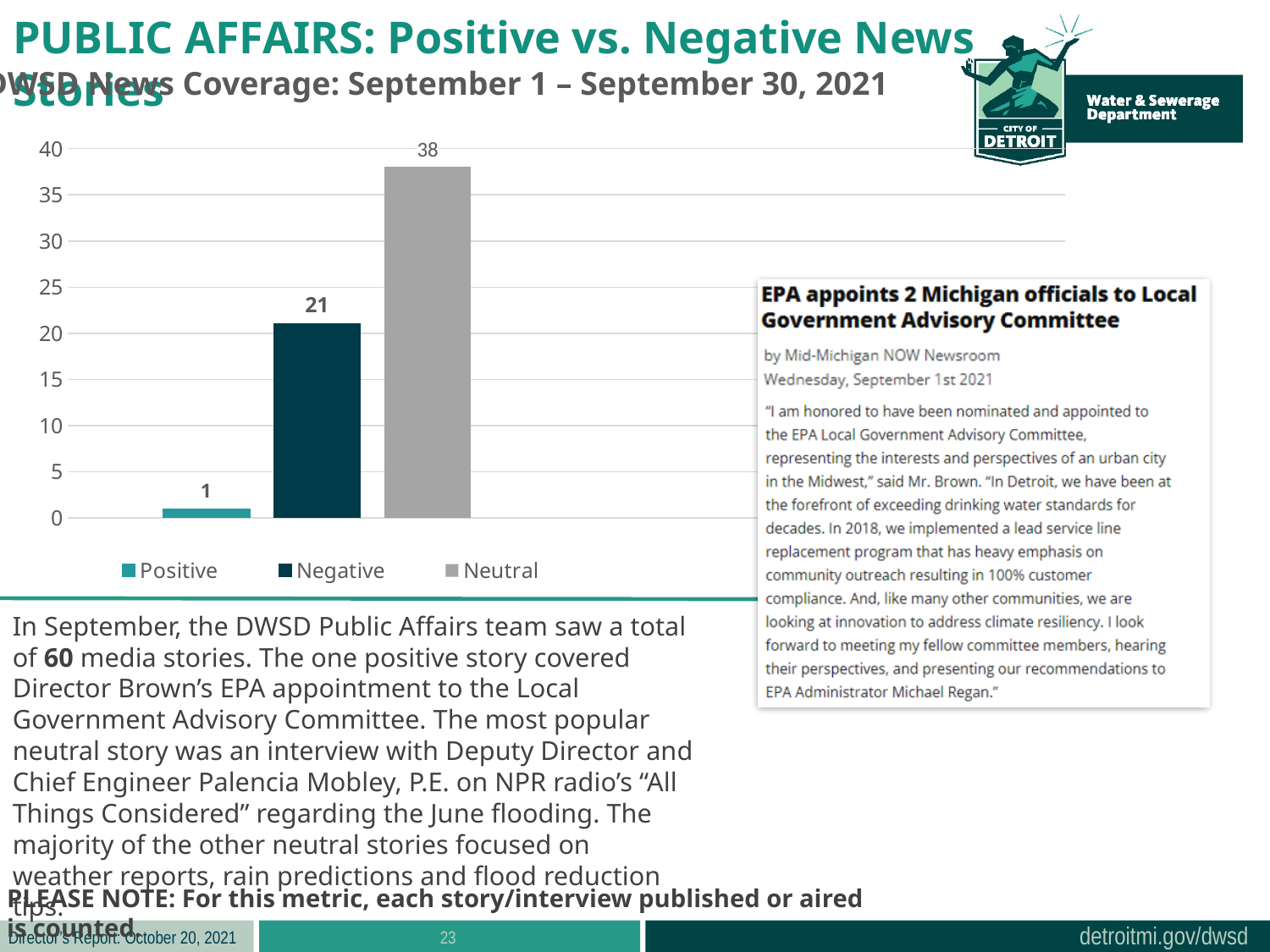
How many categories are shown in the chart? 3 What is the difference between the Neutral and Negative story counts? 17 What kind of chart is shown on the slide? bar chart What is the difference between the Negative and Positive story counts? 20 What is the value for Neutral news stories? 38 What is the value for Negative news stories? 21 Which category has the highest number of stories? Neutral Which category has the lowest number of stories? Positive Which is larger, the value for Negative or the value for Positive? Negative How many entries does the chart legend list? 3 What is the value for Positive news stories? 1 Is the value for Neutral greater or less than 35? greater